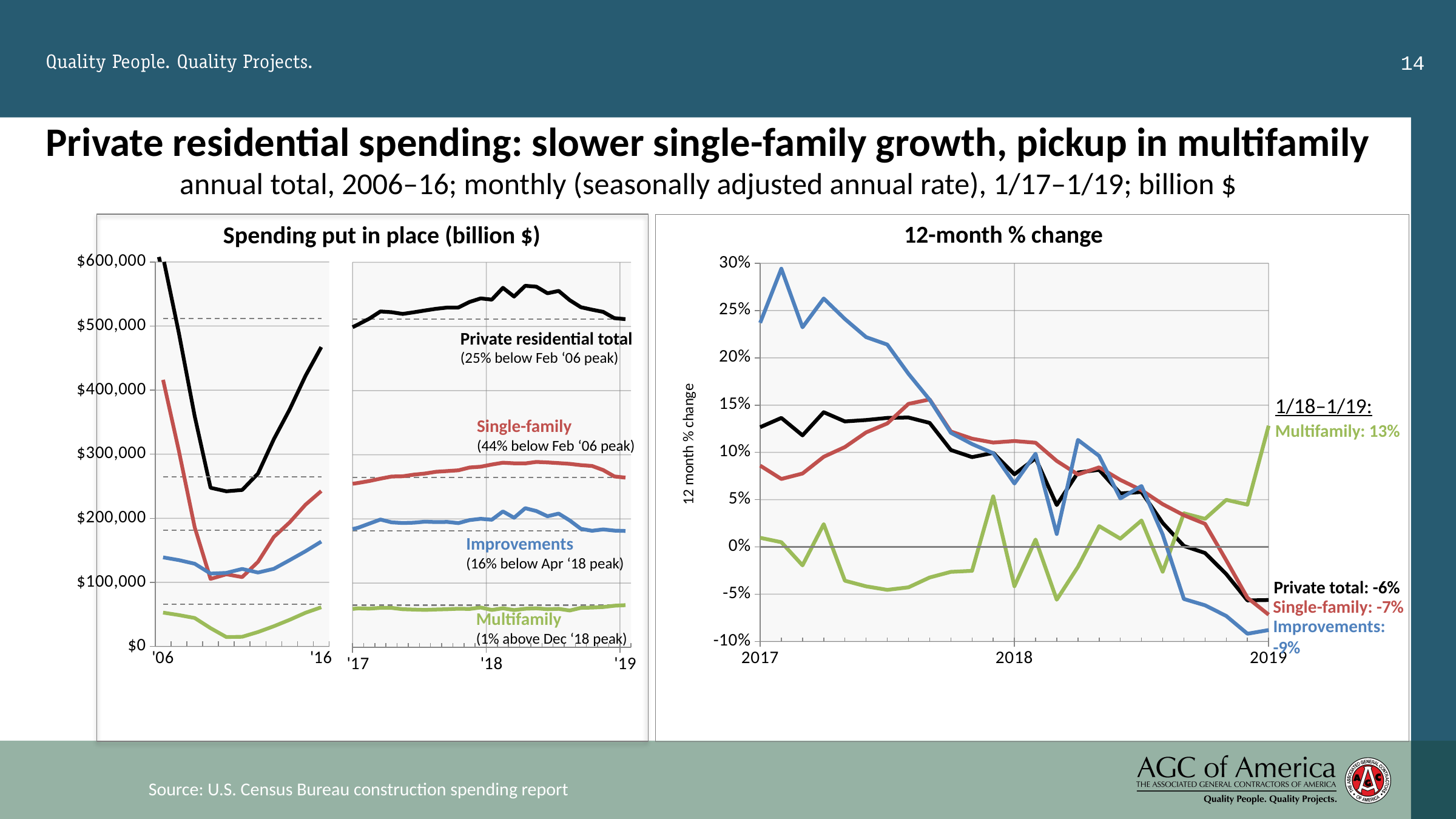
In the "12-month % change" chart, what is the 1/18–1/19 change for Single-family? -7% In the "12-month % change" chart, what is the difference between the 1/18–1/19 changes for Multifamily and Improvements? 22 percentage points In the "12-month % change" chart, which has the larger 1/18–1/19 change, Single-family or Improvements? Single-family In the "12-month % change" chart, what is the 1/18–1/19 change for Improvements? -9% What kind of chart is the "12-month % change" chart on the right? line chart In the "12-month % change" chart, what is the 1/18–1/19 change for Multifamily? 13% In the "12-month % change" chart, which category has the highest 1/18–1/19 change? Multifamily In the "12-month % change" chart, what is the 1/18–1/19 change for Private total? -6% In the "12-month % change" chart, does the Improvements line rise or fall from 2017 to 2019? fall In the "12-month % change" chart, which category has the lowest 1/18–1/19 change? Improvements In the "Spending put in place (billion $)" chart, is the Private residential total value for '06 greater or less than $500,000? greater